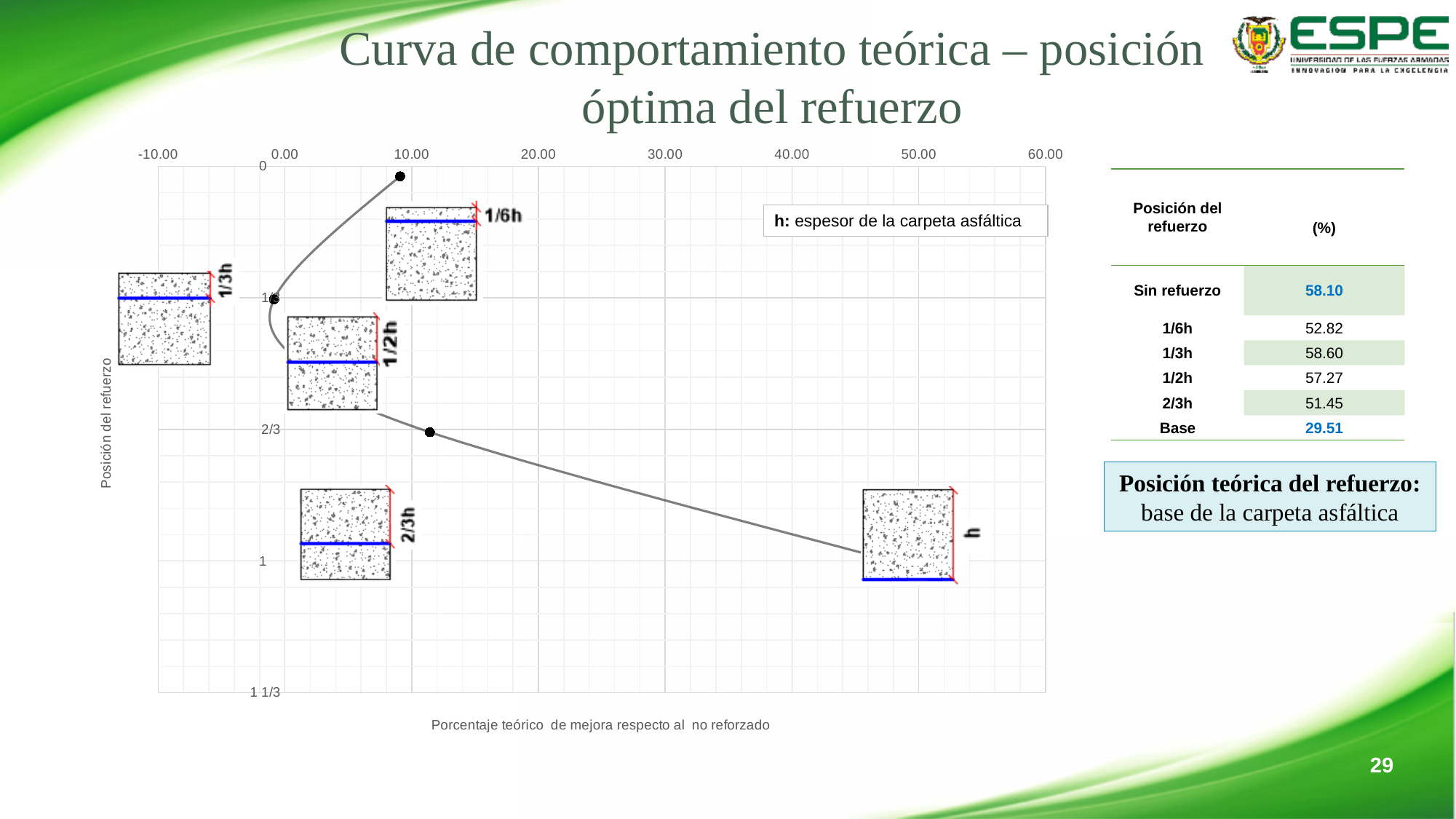
Which reinforcement position on the chart has the highest theoretical improvement percentage? 1 (base, h) What kind of chart is shown on the slide? scatter chart Which has a larger improvement percentage on the chart: the reinforcement at position 1 or at position 2/3? position 1 Which has a larger improvement percentage on the chart: the reinforcement at position 0 or at position 1/3? position 0 What is the title of the y axis of the chart? Posición del refuerzo Is the improvement percentage for the reinforcement at position 1/3 greater or less than 10.00? less Is the improvement percentage for the reinforcement at position 1 (base, h) greater or less than 40.00? greater Is the improvement percentage for the reinforcement at position 1 (base, h) greater or less than 60.00? less What is the title of the x axis of the chart? Porcentaje teórico de mejora respecto al no reforzado